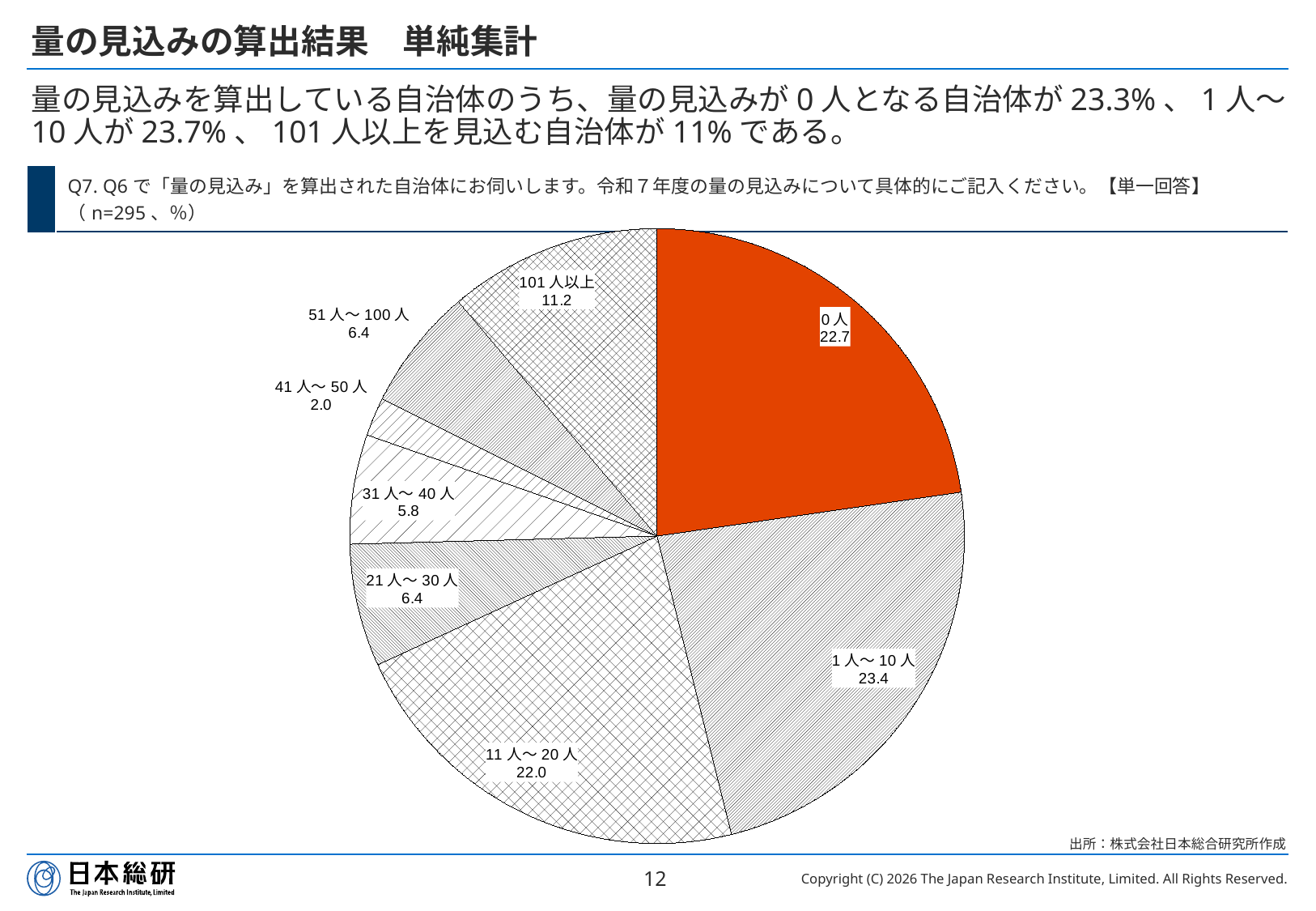
Which category has the smallest slice in the pie chart? 41人〜50人 How many slices does the pie chart have? 8 What is the value shown for the 0人 slice? 22.7 What is the value shown for the 1人〜10人 slice? 23.4 What is the value shown for the 41人〜50人 slice? 2.0 What kind of chart is shown on the slide? pie chart Which category has the largest slice in the pie chart? 1人〜10人 Which is larger, the value for 21人〜30人 or the value for 31人〜40人? 21人〜30人 What is the difference between the values for 1人〜10人 and 41人〜50人? 21.4 What is the difference between the values for 101人以上 and 51人〜100人? 4.8 What is the value shown for the 101人以上 slice? 11.2 Which slice of the pie chart is filled in solid orange? 0人